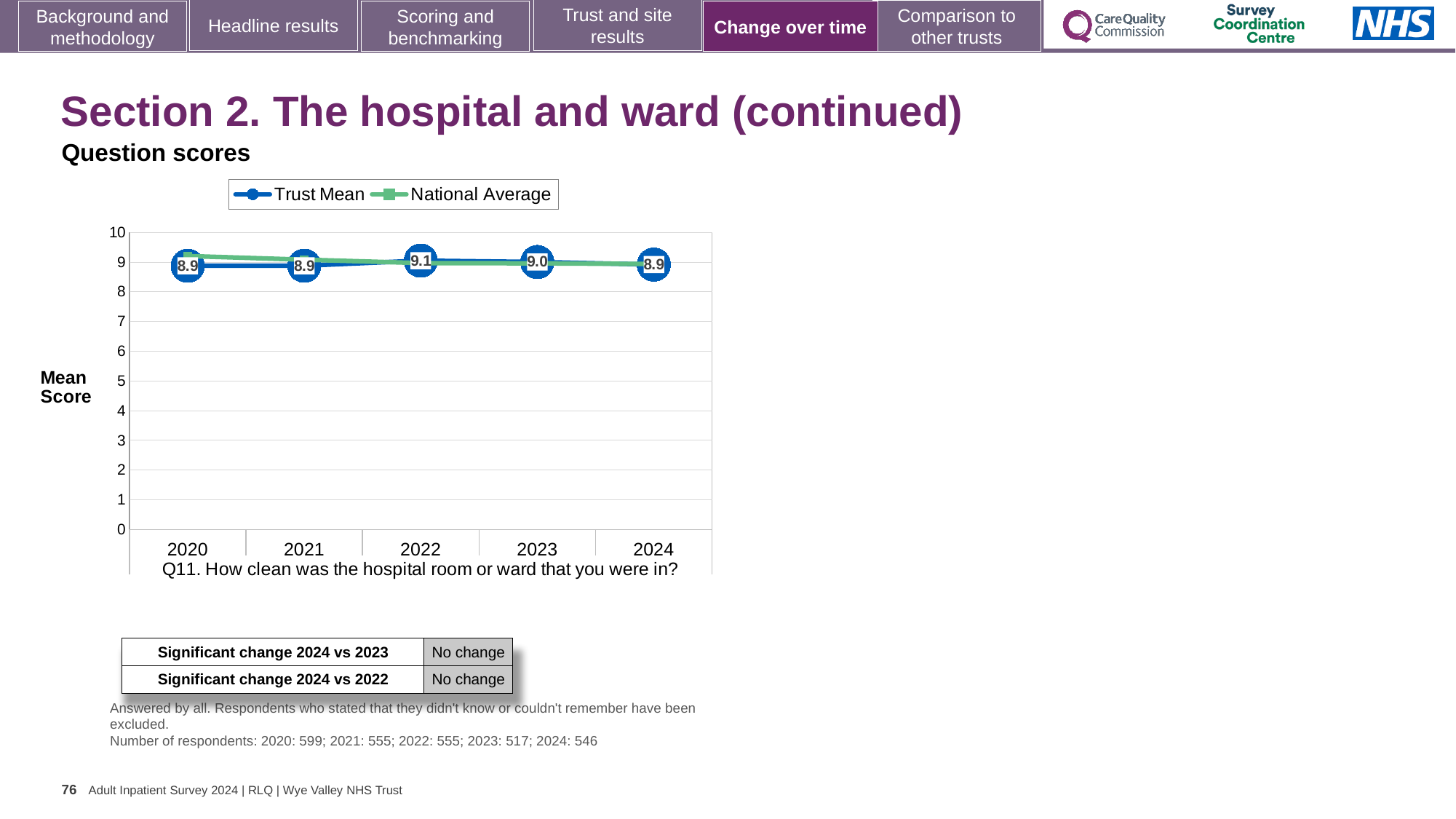
What is the Trust Mean score for 2024 on the Q11 chart? 8.9 How many years are plotted on the x axis of the Q11 chart? 5 What is the Trust Mean score for 2022 on the Q11 chart? 9.1 In which year is the Trust Mean score highest on the Q11 chart? 2022 What is the Trust Mean score for 2023 on the Q11 chart? 9.0 Does the Trust Mean score rise or fall from 2022 to 2024? Fall Which year has the larger Trust Mean score, 2022 or 2023? 2022 What kind of chart is used to show the Q11 scores? Line chart What is the label on the y axis of the Q11 chart? Mean Score Is the Trust Mean score for 2021 greater or less than 5? greater How many series does the legend of the Q11 chart list? 2 What is the difference between the Trust Mean scores for 2022 and 2024? 0.2